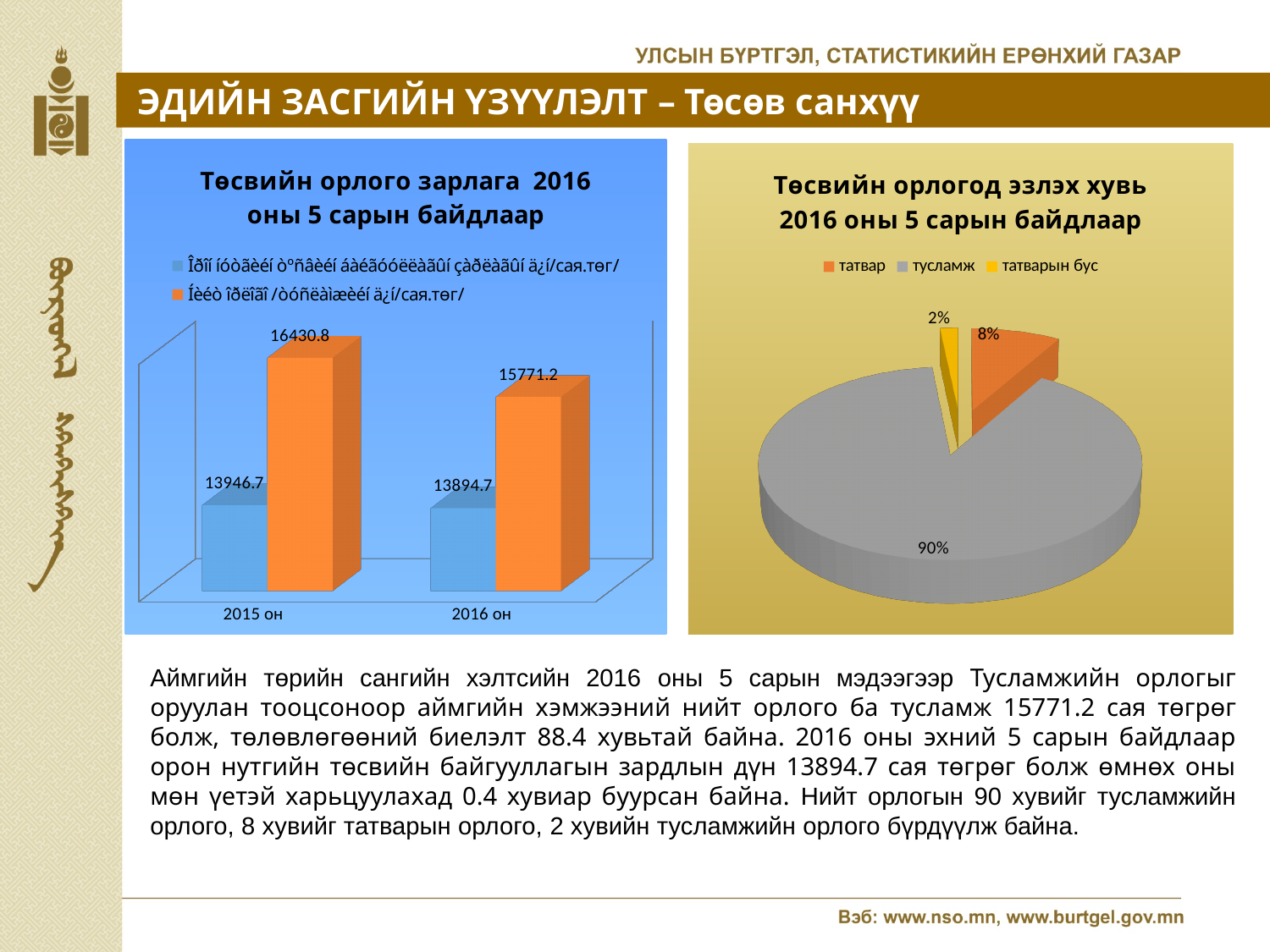
In the left chart 'Төсвийн орлого зарлага 2016 оны 5 сарын байдлаар', which year has the higher orange bar, 2015 он or 2016 он? 2015 он In the right chart 'Төсвийн орлогод эзлэх хувь 2016 оны 5 сарын байдлаар', what share does тусламж have? 90% In the left chart 'Төсвийн орлого зарлага 2016 оны 5 сарын байдлаар', what is the value of the blue bar for 2016 он? 13894.7 How many entries does the legend of the right chart 'Төсвийн орлогод эзлэх хувь 2016 оны 5 сарын байдлаар' list? 3 In the left chart 'Төсвийн орлого зарлага 2016 оны 5 сарын байдлаар', what is the value of the orange bar for 2015 он? 16430.8 In the left chart 'Төсвийн орлого зарлага 2016 оны 5 сарын байдлаар', what is the difference between the orange bar values for 2015 он and 2016 он? 659.6 In the left chart 'Төсвийн орлого зарлага 2016 оны 5 сарын байдлаар', do the blue bar values rise or fall from 2015 он to 2016 он? Fall In the left chart 'Төсвийн орлого зарлага 2016 оны 5 сарын байдлаар', how many categories are shown on the x axis? 2 In the right chart 'Төсвийн орлогод эзлэх хувь 2016 оны 5 сарын байдлаар', which category has the smallest slice? татварын бус In the left chart 'Төсвийн орлого зарлага 2016 оны 5 сарын байдлаар', what is the value of the orange bar for 2016 он? 15771.2 What kind of chart is the left chart 'Төсвийн орлого зарлага 2016 оны 5 сарын байдлаар'? Bar chart In the right chart 'Төсвийн орлогод эзлэх хувь 2016 оны 5 сарын байдлаар', what share does татвар have? 8%